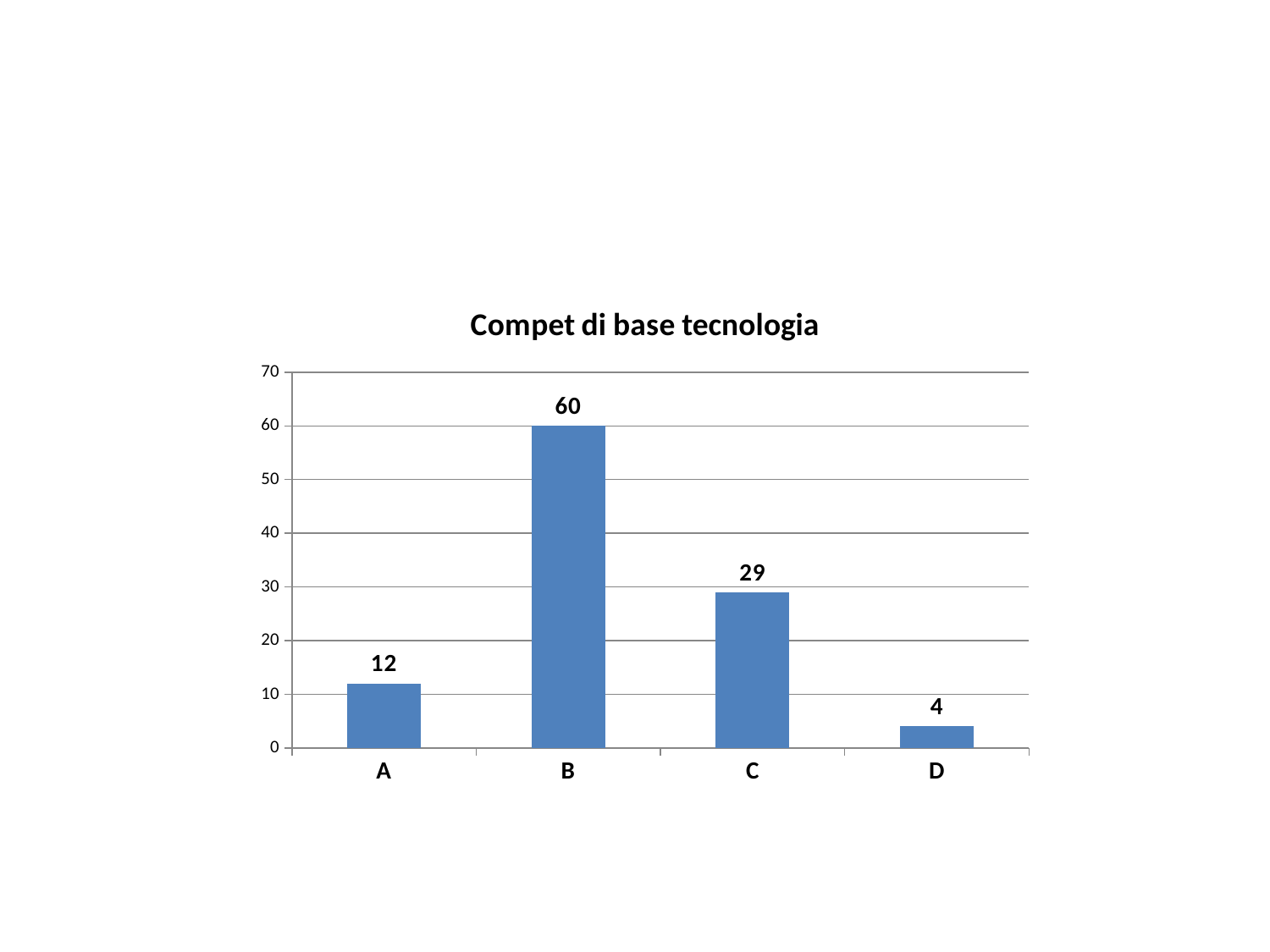
How many categories are shown on the x axis? 4 Which category has the highest value? B Is the value for C greater or less than 20? greater What is the difference between the values for B and C? 31 What kind of chart is shown on the slide? bar chart What is the title of the chart? Compet di base tecnologia What is the value for category D? 4 What is the difference between the values for A and D? 8 Which category has the lowest value? D What is the value for category B? 60 Which is larger, the value for A or the value for C? C What is the value for category A? 12